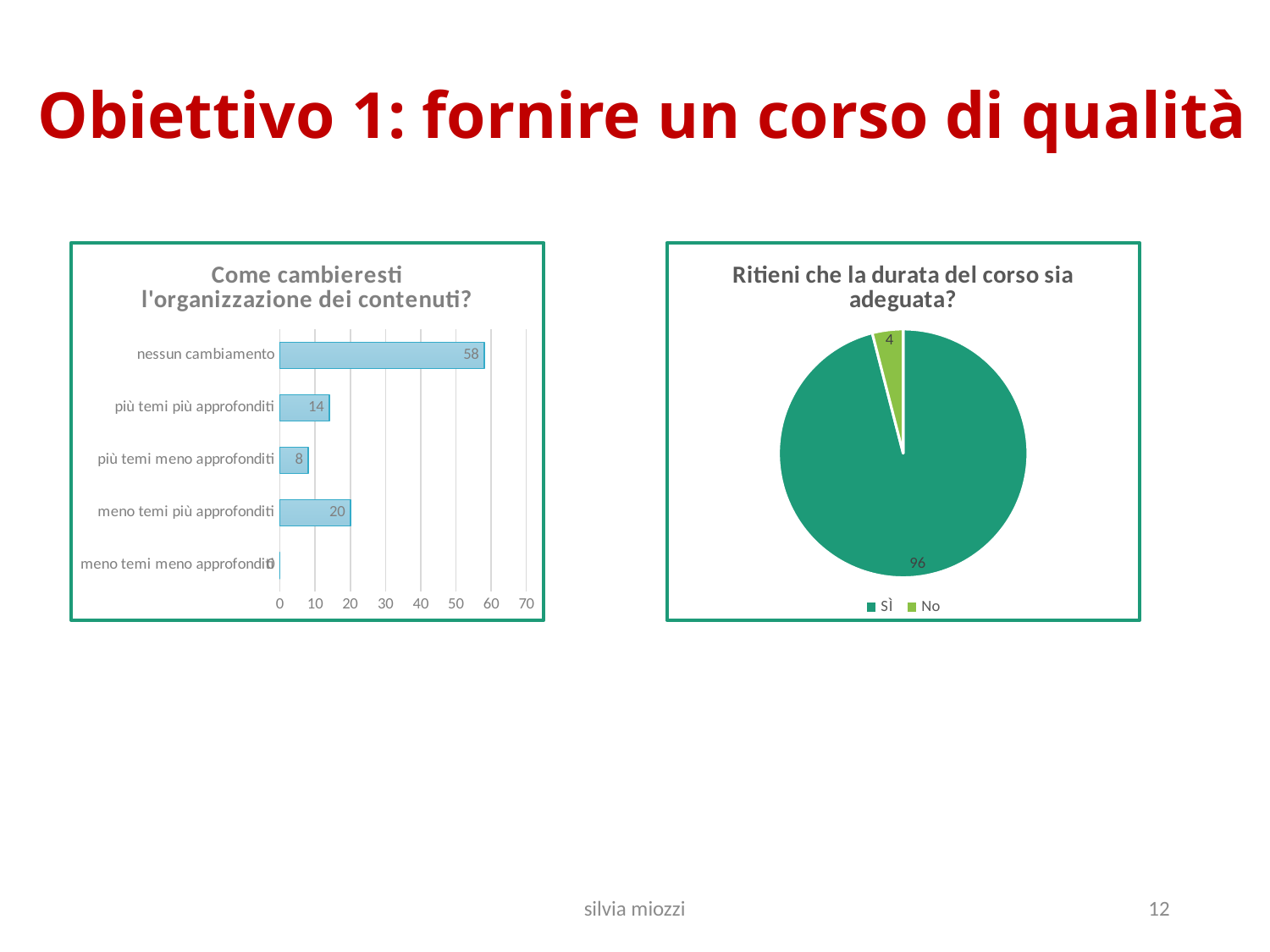
In the chart 'Ritieni che la durata del corso sia adeguata?', what is the value for 'Sì'? 96 In the chart 'Come cambieresti l'organizzazione dei contenuti?', what is the value for 'nessun cambiamento'? 58 In the chart 'Come cambieresti l'organizzazione dei contenuti?', which category has the lowest value? meno temi meno approfonditi How many entries does the legend of the chart 'Ritieni che la durata del corso sia adeguata?' list? 2 In the chart 'Come cambieresti l'organizzazione dei contenuti?', which category has the highest value? nessun cambiamento What kind of chart is 'Ritieni che la durata del corso sia adeguata?'? pie chart What kind of chart is 'Come cambieresti l'organizzazione dei contenuti?'? bar chart How many categories are shown in the chart 'Come cambieresti l'organizzazione dei contenuti?'? 5 In the chart 'Come cambieresti l'organizzazione dei contenuti?', which is larger: 'meno temi più approfonditi' or 'più temi più approfonditi'? meno temi più approfonditi In the chart 'Ritieni che la durata del corso sia adeguata?', what is the value for 'No'? 4 In the chart 'Come cambieresti l'organizzazione dei contenuti?', what is the value for 'meno temi più approfonditi'? 20 In the chart 'Come cambieresti l'organizzazione dei contenuti?', what is the difference between 'più temi più approfonditi' and 'più temi meno approfonditi'? 6